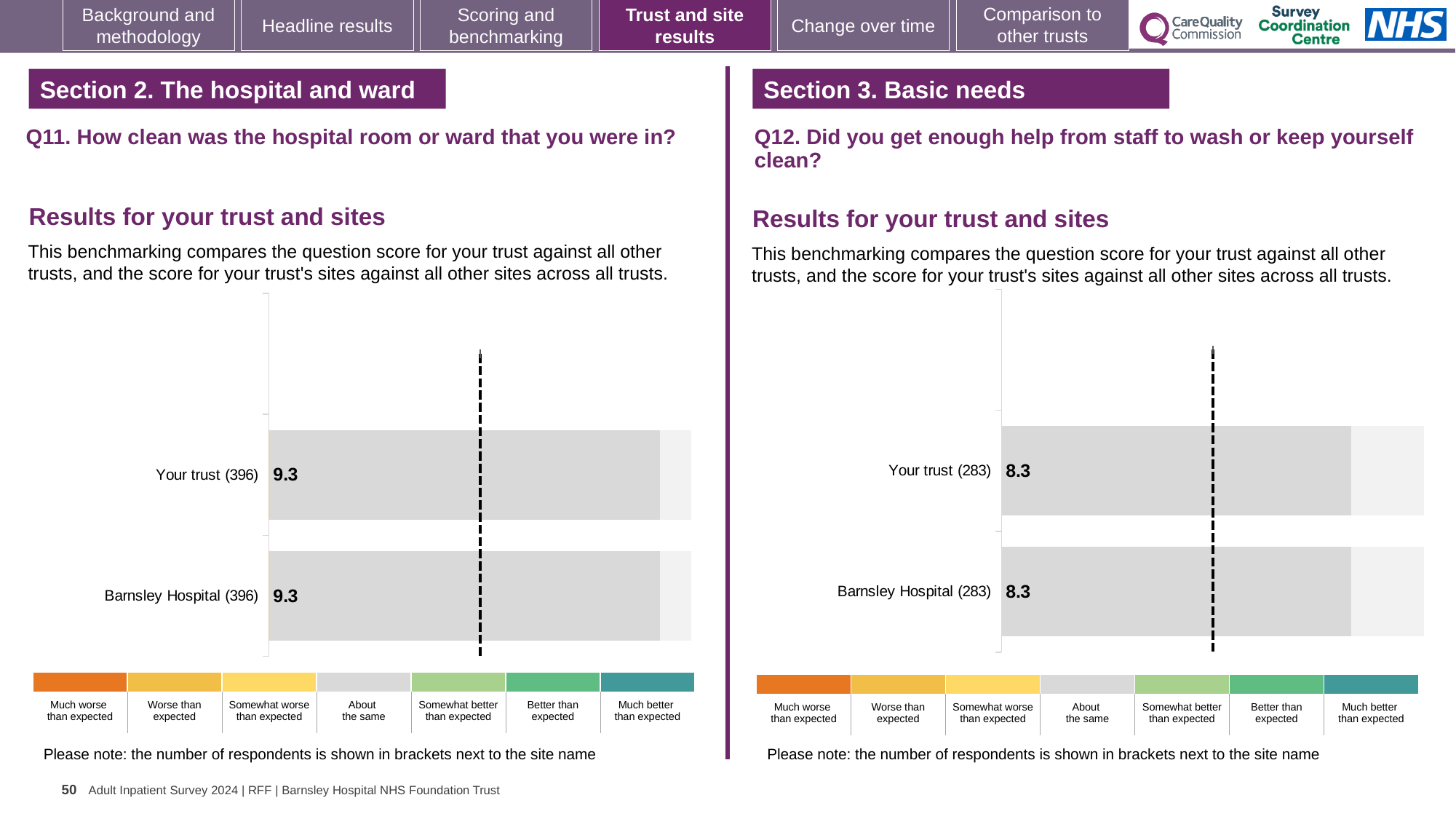
On the Q11 chart (left), how many categories does the colour key below the chart list? 7 What kind of chart is the Q12 chart (right)? Bar chart On the Q12 chart (right), how many respondents are shown in brackets next to Barnsley Hospital? 283 On the Q12 chart (right), what is the score for Your trust? 8.3 How many bars are plotted on the Q11 chart (left)? 2 On the Q12 chart (right), what is the difference between the score for Your trust and the score for Barnsley Hospital? 0 On the Q12 chart (right), what is the score for Barnsley Hospital? 8.3 On the Q11 chart (left), what is the score for Barnsley Hospital? 9.3 On the Q11 chart (left), what is the difference between the score for Your trust and the score for Barnsley Hospital? 0 On the Q12 chart (right), which category in the colour key does the grey colour of the bars correspond to? About the same On the Q11 chart (left), what is the score for Your trust? 9.3 On the Q11 chart (left), how many respondents are shown in brackets next to Your trust? 396